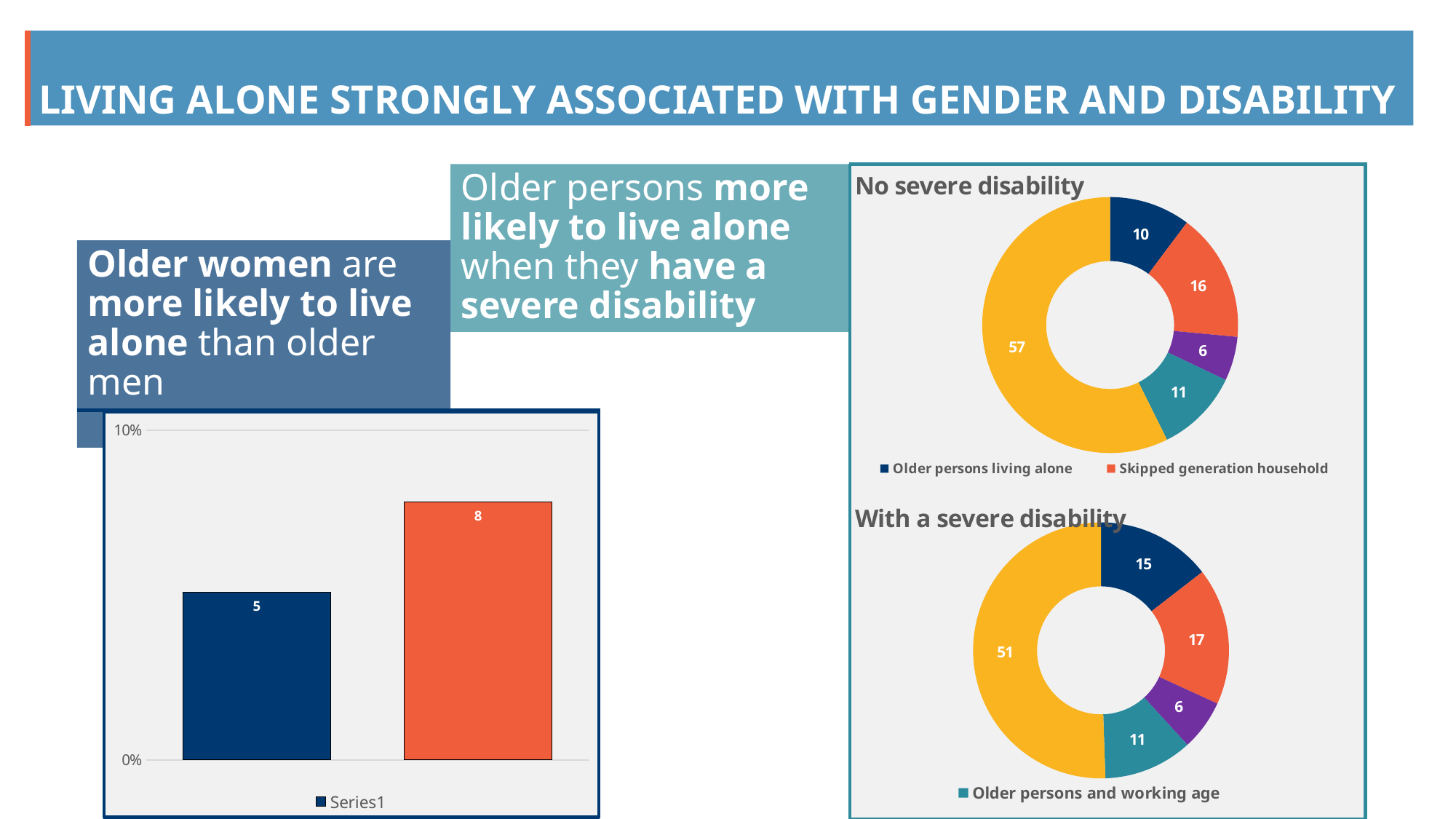
In the bar chart at the bottom left, what is the highest value shown on the vertical axis? 10% How many bars are plotted in the bar chart at the bottom left? 2 In the 'No severe disability' doughnut chart, what is the value for Skipped generation household? 16 In the bar chart at the bottom left, what is the value of the dark blue bar? 5 In the 'With a severe disability' doughnut chart, what is the value for Older persons living alone? 15 In the 'With a severe disability' doughnut chart, what is the value of the largest slice? 51 In the bar chart at the bottom left, what is the value of the orange bar? 8 In the 'No severe disability' doughnut chart, what is the value for Older persons living alone? 10 In the bar chart at the bottom left, what is the difference between the orange bar and the dark blue bar? 3 In the 'With a severe disability' doughnut chart, what is the value for Older persons and working age? 11 Which chart has the larger value for Older persons living alone, 'No severe disability' or 'With a severe disability'? With a severe disability What kind of chart is the chart at the bottom left of the slide? bar chart